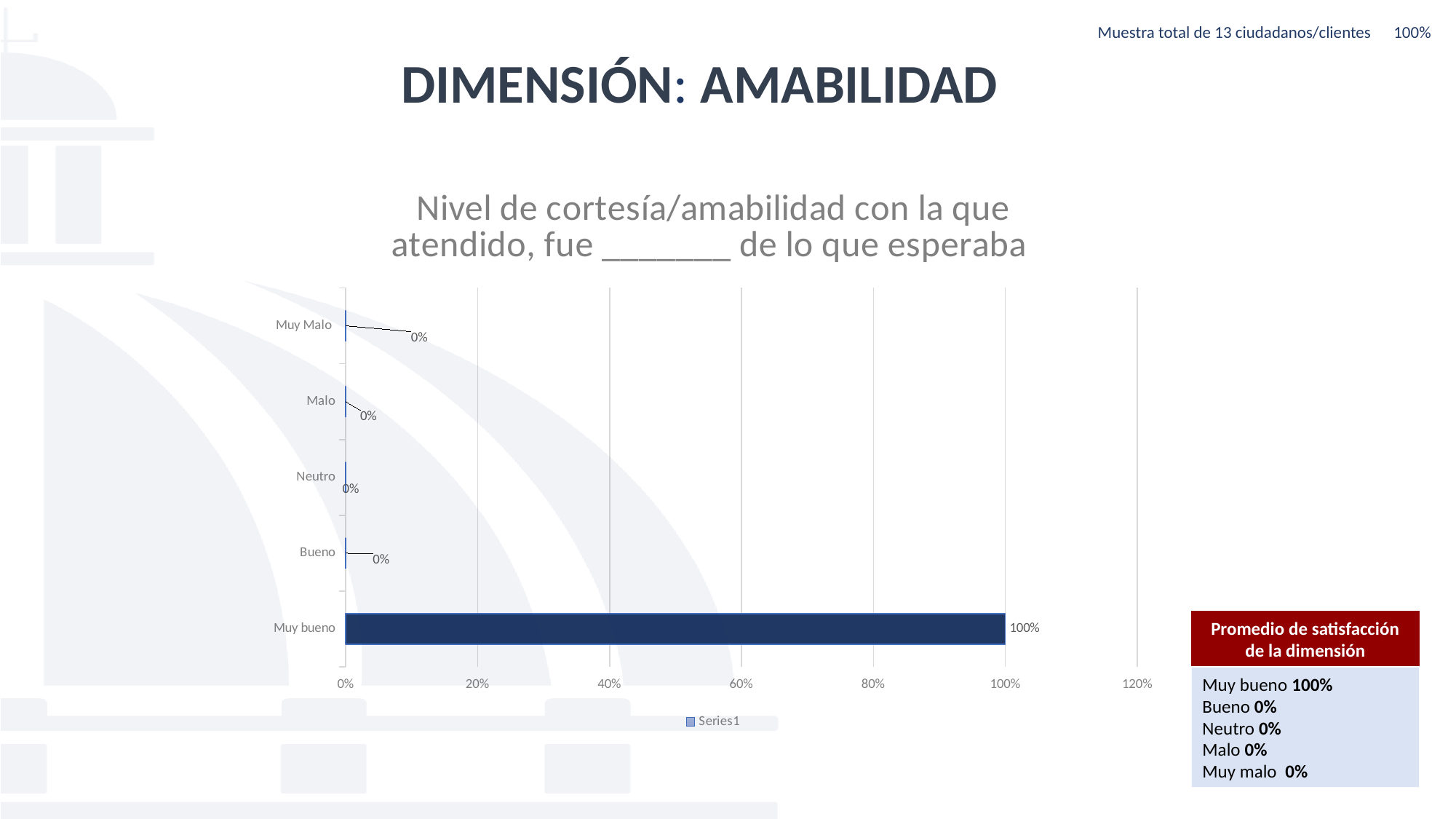
What is the value for Bueno? 0% How many series does the legend list? 1 What kind of chart is shown on the slide? bar chart What is the name of the series listed in the legend? Series1 What is the value for Muy Malo? 0% How many categories are shown on the chart? 5 Which is larger, the value for Muy bueno or the value for Bueno? Muy bueno What is the value for Muy bueno? 100% What is the value for Neutro? 0% What is the difference between the values for Muy bueno and Malo? 100% Which category has the highest value? Muy bueno Is the value for Muy bueno greater or less than 80%? greater